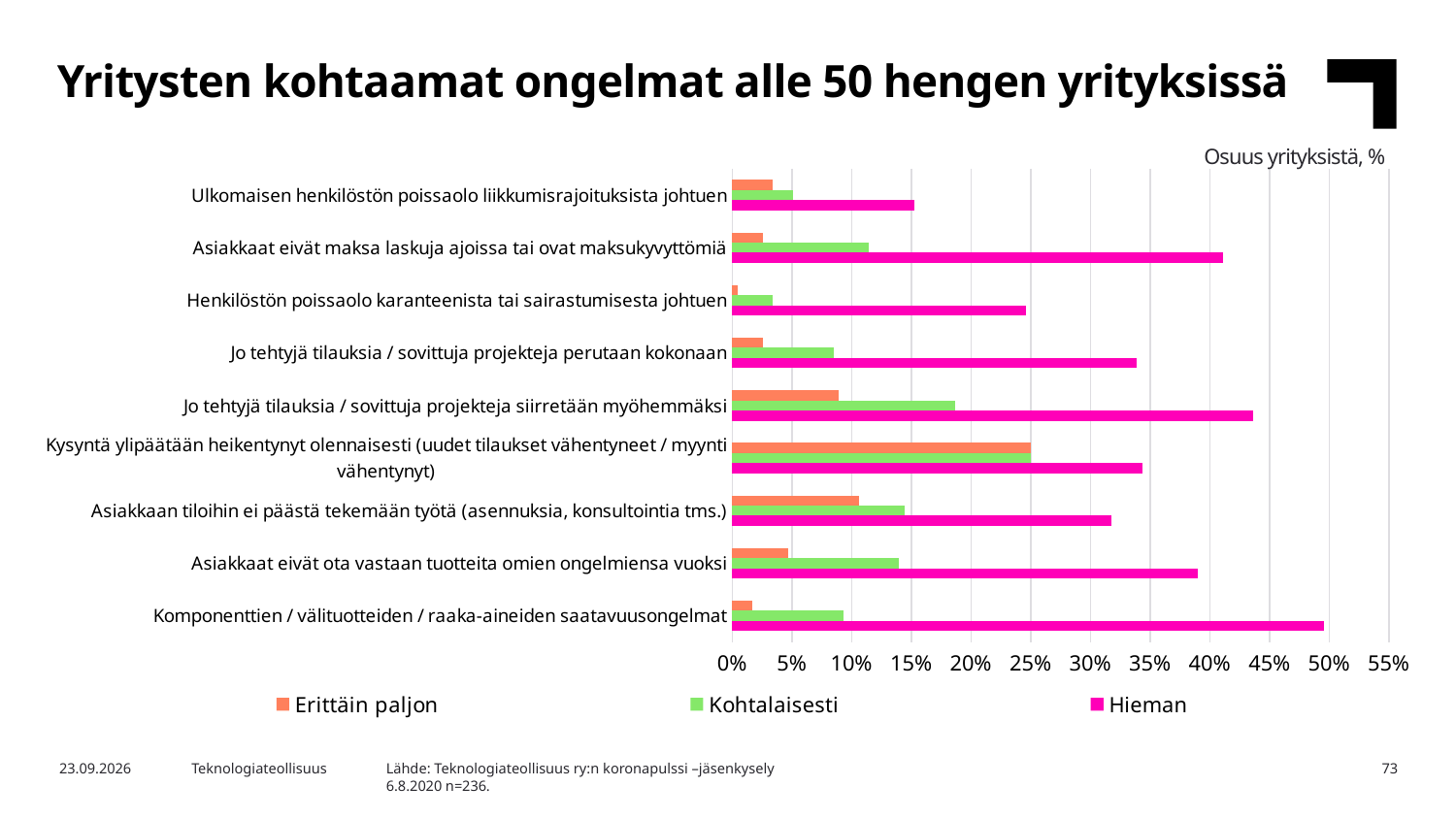
Which category has the lowest value for the Hieman series? Ulkomaisen henkilöstön poissaolo liikkumisrajoituksista johtuen How many series does the legend list? 3 What kind of chart is shown on the slide? Bar chart What unit label is shown above the chart? Osuus yrityksistä, % Is the Hieman value for Ulkomaisen henkilöstön poissaolo liikkumisrajoituksista johtuen greater or less than 20%? less Which category has the highest value for the Erittäin paljon series? Kysyntä ylipäätään heikentynyt olennaisesti (uudet tilaukset vähentyneet / myynti vähentynyt) Which series is shown in magenta according to the legend? Hieman How many categories (problems) are listed on the chart? 9 For the Hieman series, which is larger: Asiakkaat eivät ota vastaan tuotteita omien ongelmiensa vuoksi or Jo tehtyjä tilauksia / sovittuja projekteja perutaan kokonaan? Asiakkaat eivät ota vastaan tuotteita omien ongelmiensa vuoksi Is the Erittäin paljon value for Kysyntä ylipäätään heikentynyt olennaisesti greater or less than 20%? greater Which category has the highest value for the Hieman series? Komponenttien / välituotteiden / raaka-aineiden saatavuusongelmat Is the Hieman value for Komponenttien / välituotteiden / raaka-aineiden saatavuusongelmat greater or less than 45%? greater